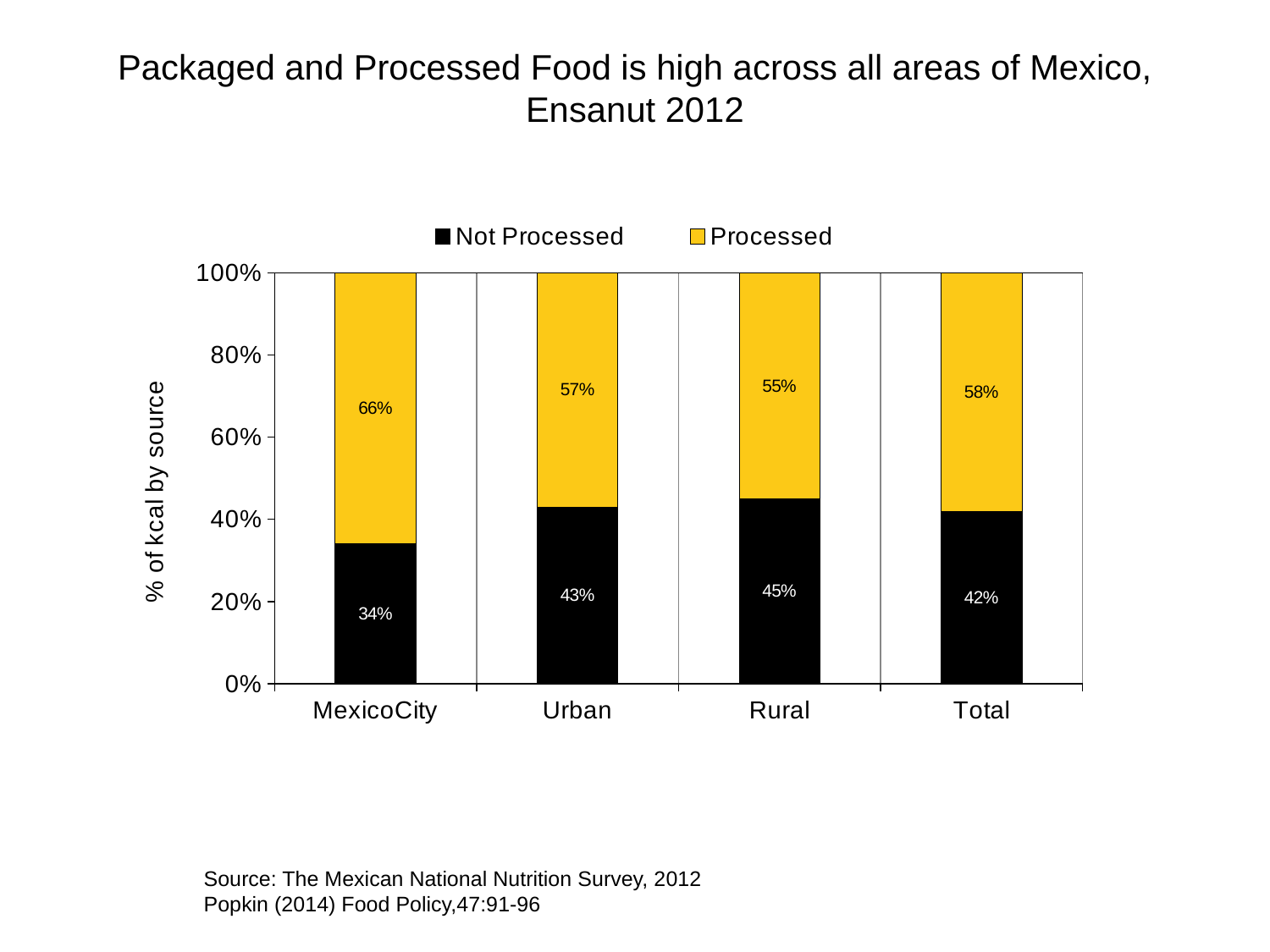
What kind of chart is shown? Stacked bar chart What is the difference between the Processed values for MexicoCity and Rural? 11% Which category has the highest Processed value? MexicoCity What is the y-axis label of the chart? % of kcal by source What is the total of the stacked bar for Urban? 100% Which is larger, the Not Processed value for Urban or for Rural? Rural How many categories are shown on the x axis? 4 What is the Processed value for MexicoCity? 66% How many series does the legend list? 2 What is the Processed value for Total? 58% Which category has the lowest Not Processed value? MexicoCity What is the Not Processed value for Rural? 45%